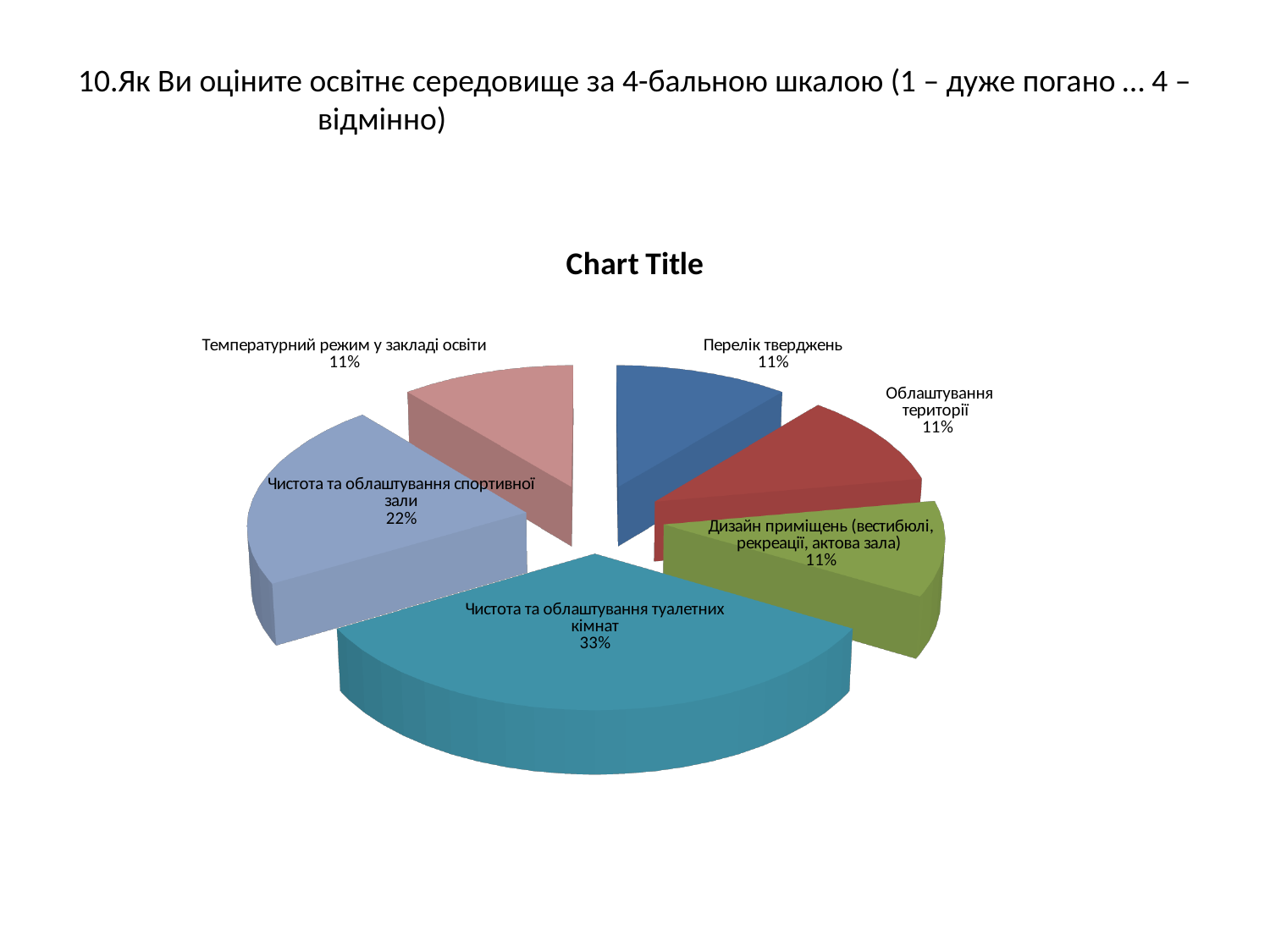
What share of the pie is "Чистота та облаштування туалетних кімнат"? 33% What is the title of the chart? Chart Title What is the combined share of "Чистота та облаштування туалетних кімнат" and "Чистота та облаштування спортивної зали"? 55% What is the difference in percentage points between "Чистота та облаштування туалетних кімнат" and "Чистота та облаштування спортивної зали"? 11 What share of the pie is "Дизайн приміщень (вестибюлі, рекреації, актова зала)"? 11% Which category has the largest slice of the pie? Чистота та облаштування туалетних кімнат What share of the pie is "Чистота та облаштування спортивної зали"? 22% Which is larger: the slice for "Чистота та облаштування спортивної зали" or the slice for "Облаштування території"? Чистота та облаштування спортивної зали How many slices are labelled 11%? 4 How many slices does the pie chart have? 6 What kind of chart is shown on the slide? pie chart